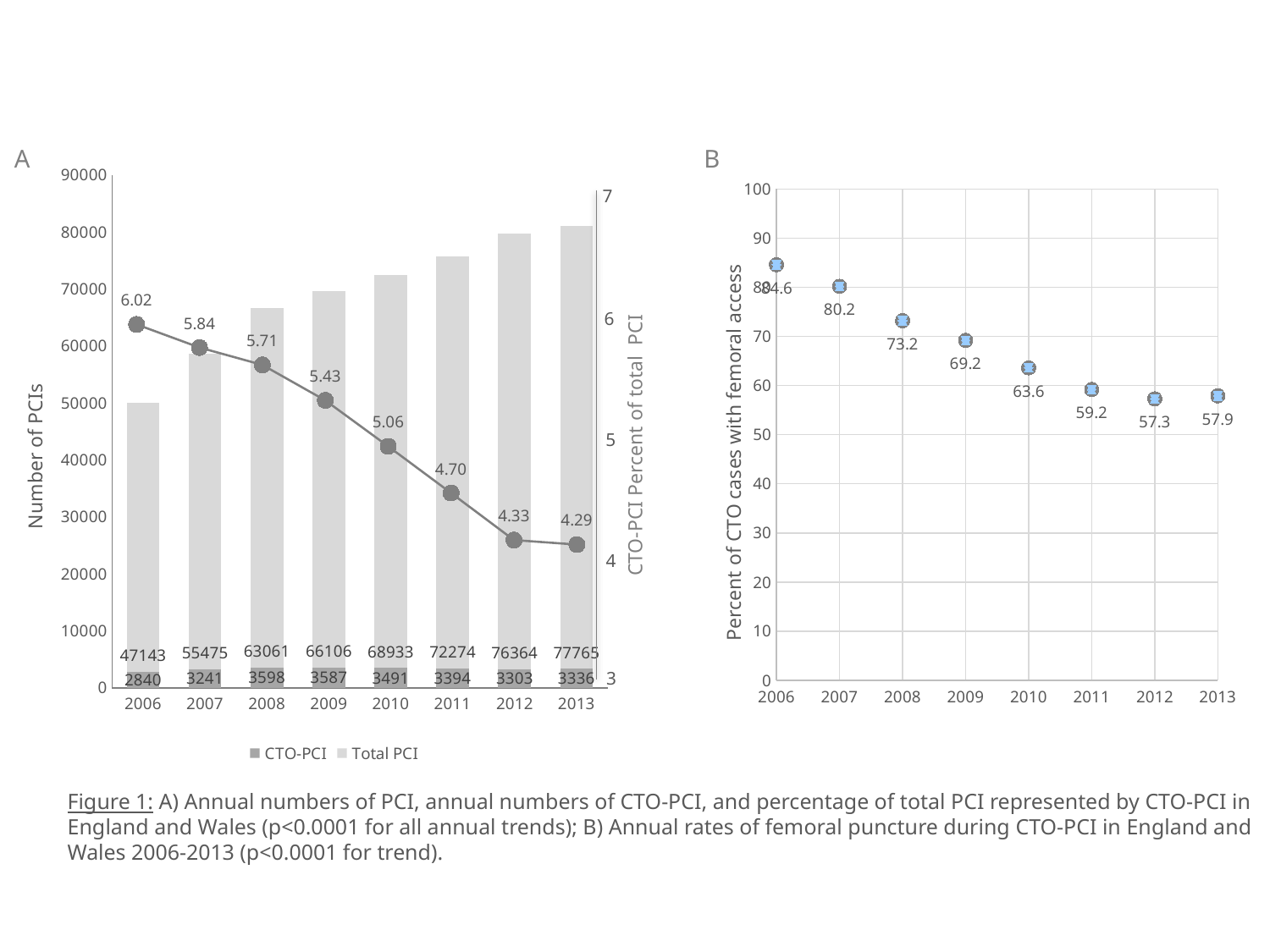
In chart B, is the value for 2006 greater or less than 80? greater How many data points are plotted in chart B? 8 In chart B, which year has the lowest percent of CTO cases with femoral access? 2012 In chart B, what is the percent of CTO cases with femoral access in 2010? 63.6 How many series does the legend of chart A list? 2 In chart A, what is the Total PCI value for 2010? 68933 In chart A, does the CTO-PCI percent of total PCI line rise or fall from 2006 to 2013? fall In chart A, which year has the lowest CTO-PCI value? 2006 In chart A, what is the CTO-PCI value for 2008? 3598 In chart A, what is the difference between the Total PCI values for 2013 and 2006? 30622 In chart A, which year has the highest CTO-PCI value? 2008 In chart A, what is the CTO-PCI percent of total PCI for 2011? 4.70